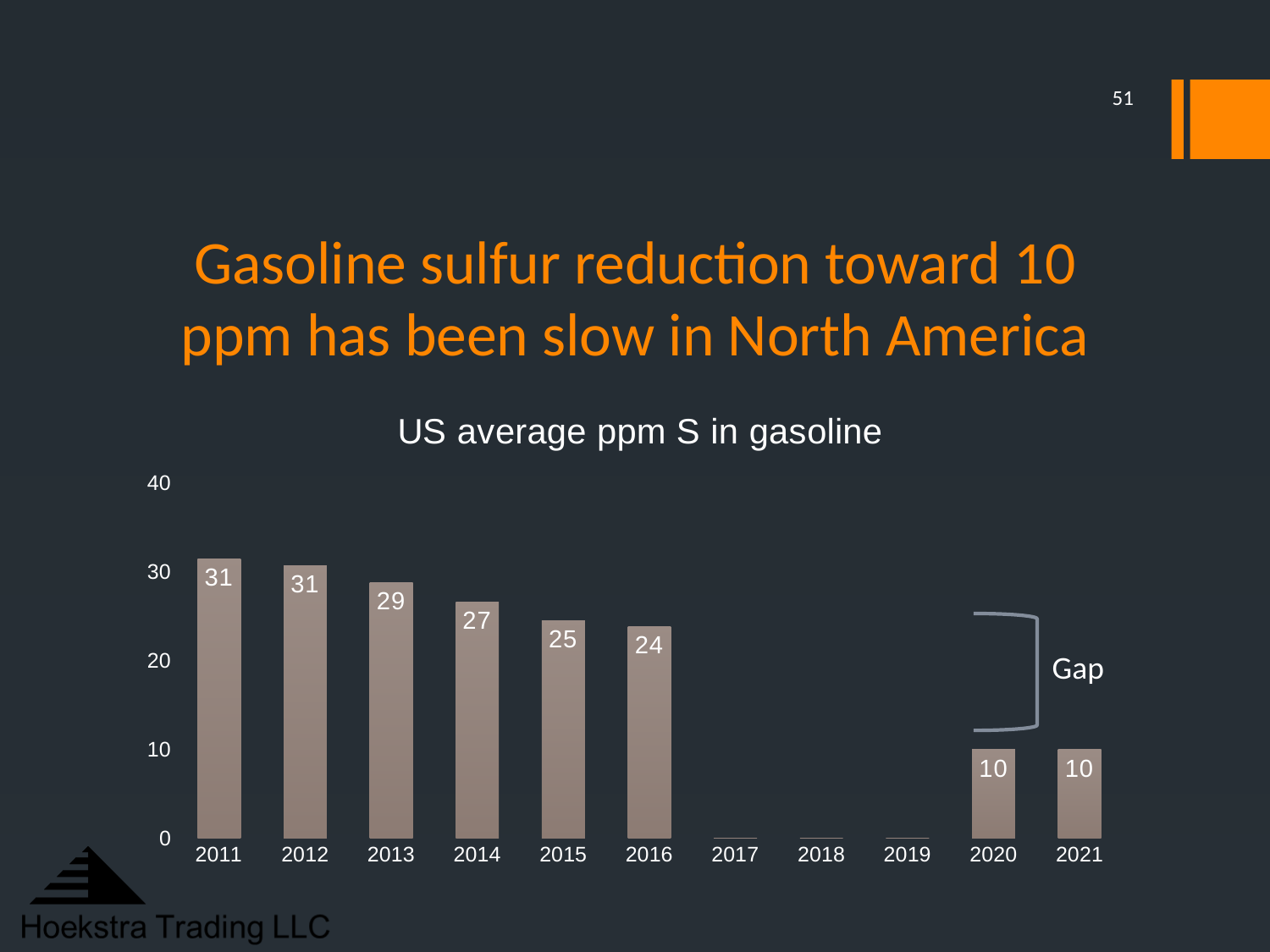
What is the value shown for 2016? 24 Is the value for 2014 greater or less than 30? less Which year has the lowest labelled value among 2011 to 2016? 2016 What is the value shown for 2014? 27 What is the US average ppm S in gasoline for 2011? 31 Which is larger, the value for 2013 or the value for 2015? 2013 What is the difference between the values for 2011 and 2016? 7 How many years are shown on the x axis? 11 What is the difference between the values for 2016 and 2020? 14 Do the values rise or fall from 2011 to 2016? fall What is the value shown for 2020? 10 What kind of chart is shown on the slide? bar chart